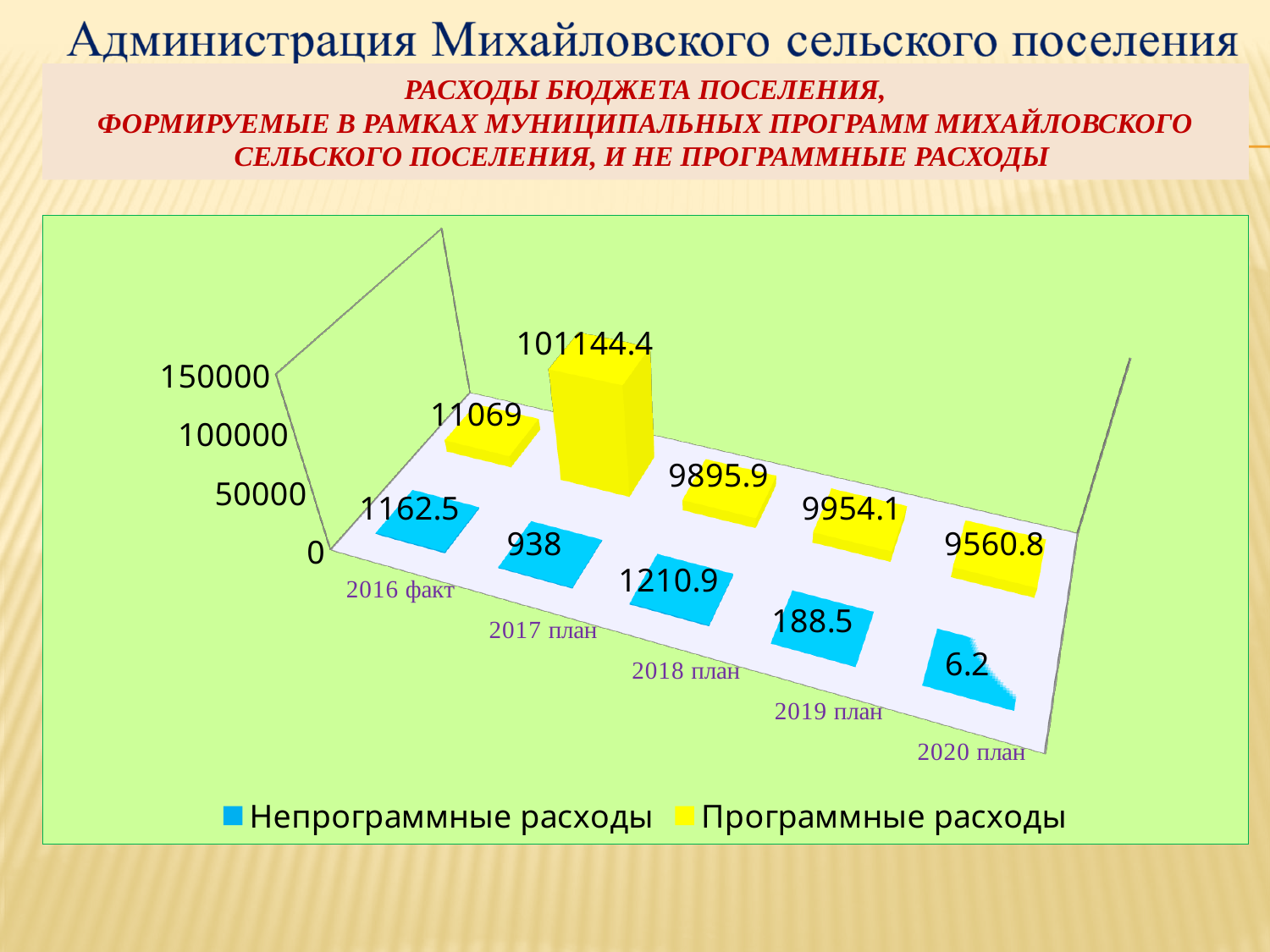
What is the value of Программные расходы for 2017 план? 101144.4 Which is larger: Программные расходы for 2019 план or for 2020 план? 2019 план What is the difference between Непрограммные расходы for 2018 план and 2017 план? 272.9 How many series does the legend list? 2 Which category has the highest value for Программные расходы? 2017 план What is the value of Непрограммные расходы for 2020 план? 6.2 Which colour represents Непрограммные расходы in the chart? blue What is the value of Программные расходы for 2016 факт? 11069 Which category has the lowest value for Непрограммные расходы? 2020 план What is the value of Непрограммные расходы for 2019 план? 188.5 What kind of chart is shown on the slide? bar chart How many categories are shown on the x axis? 5